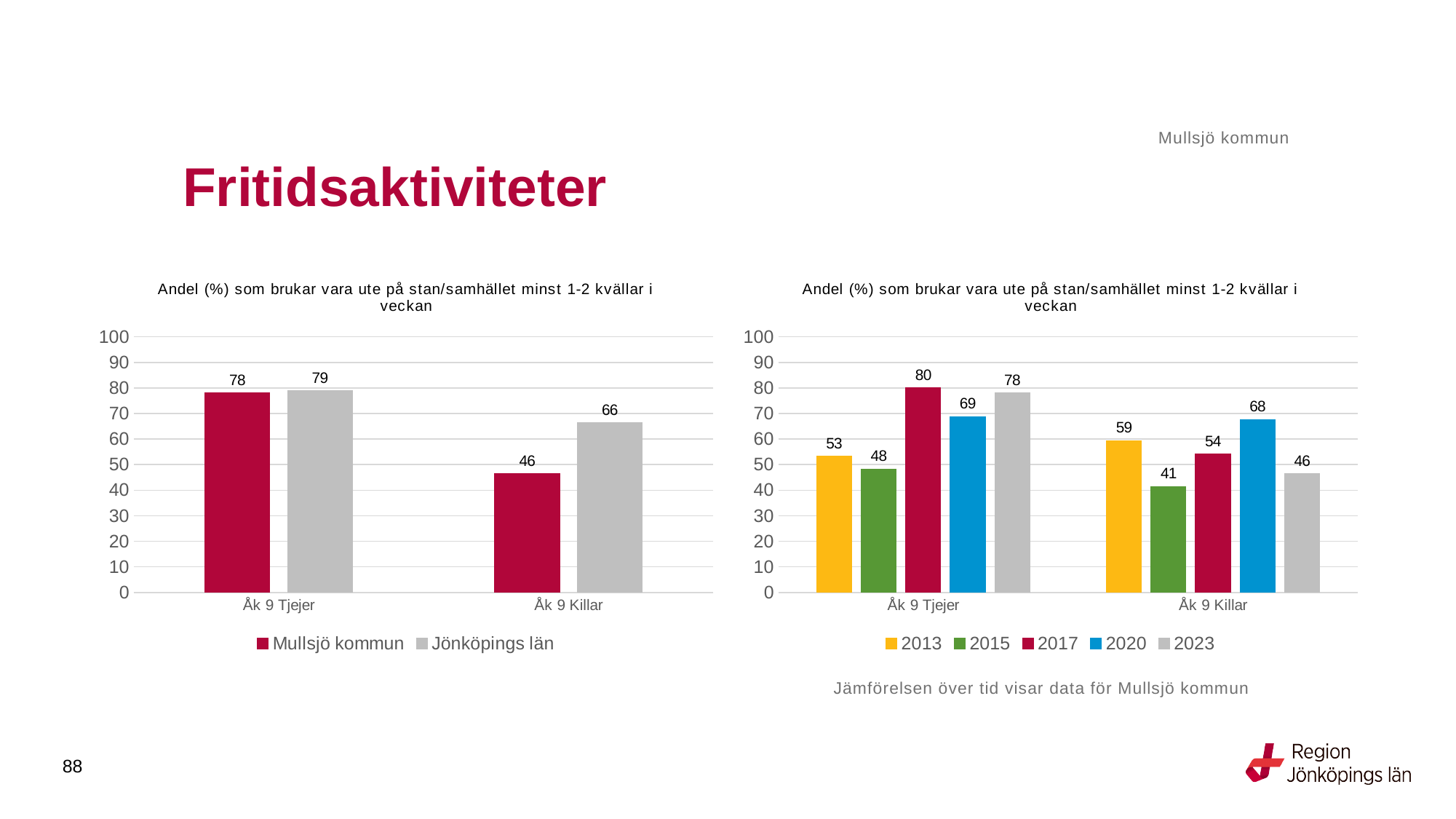
In the right chart, which is larger for Åk 9 Tjejer: the 2013 value or the 2020 value? 2020 In the left chart, what is the value for Mullsjö kommun for Åk 9 Tjejer? 78 In the right chart, what is the difference between the 2020 and 2023 values for Åk 9 Killar? 22 In the right chart, which year has the highest value for Åk 9 Tjejer? 2017 In the left chart, what is the value for Jönköpings län for Åk 9 Killar? 66 In the right chart, what is the value for 2015 for Åk 9 Killar? 41 In the left chart, what is the difference between Jönköpings län and Mullsjö kommun for Åk 9 Killar? 20 In the left chart, how many series does the legend list? 2 In the right chart, which year has the lowest value for Åk 9 Killar? 2015 In the right chart, how many series does the legend list? 5 In the right chart, what is the value for 2017 for Åk 9 Tjejer? 80 What type of chart is the left chart? Bar chart